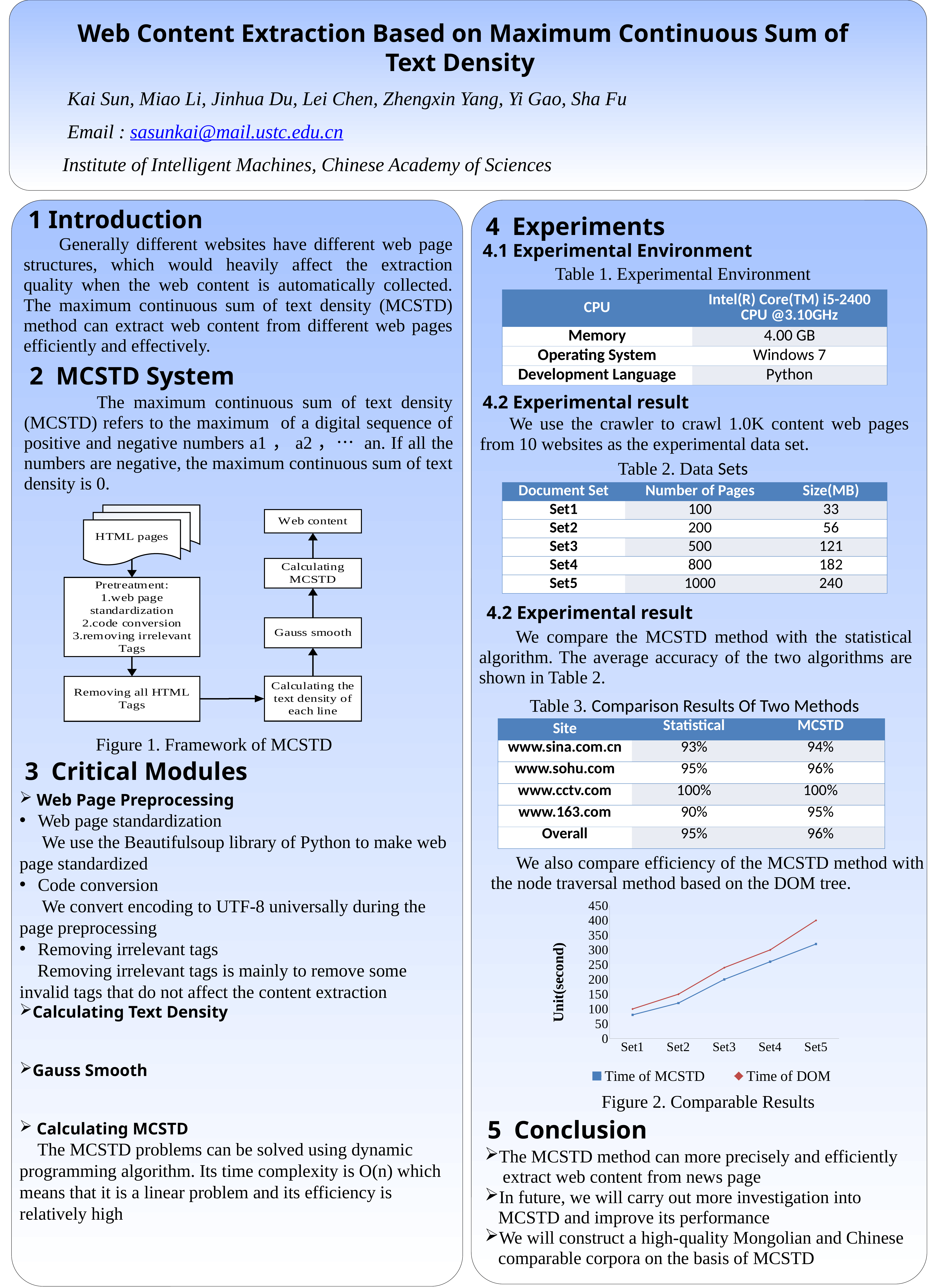
What kind of chart is Figure 2. Comparable Results? line chart In Figure 2, for which set is Time of MCSTD lowest? Set1 In Figure 2, for which set is Time of DOM highest? Set5 In Figure 2, does Time of MCSTD rise or fall from Set1 to Set5? rise How many series does the legend of Figure 2 list? 2 In Figure 2, at Set5, which is larger: Time of DOM or Time of MCSTD? Time of DOM In Figure 2, is the Time of MCSTD value for Set3 greater or less than 250? less How many data sets are shown along the x axis of Figure 2? 5 In Figure 2, is the Time of MCSTD value for Set1 greater or less than 100? less In Figure 2, is the Time of DOM value for Set5 greater or less than 350? greater In Figure 2, which series is plotted in red? Time of DOM What is the y-axis label of Figure 2? Unit(second)